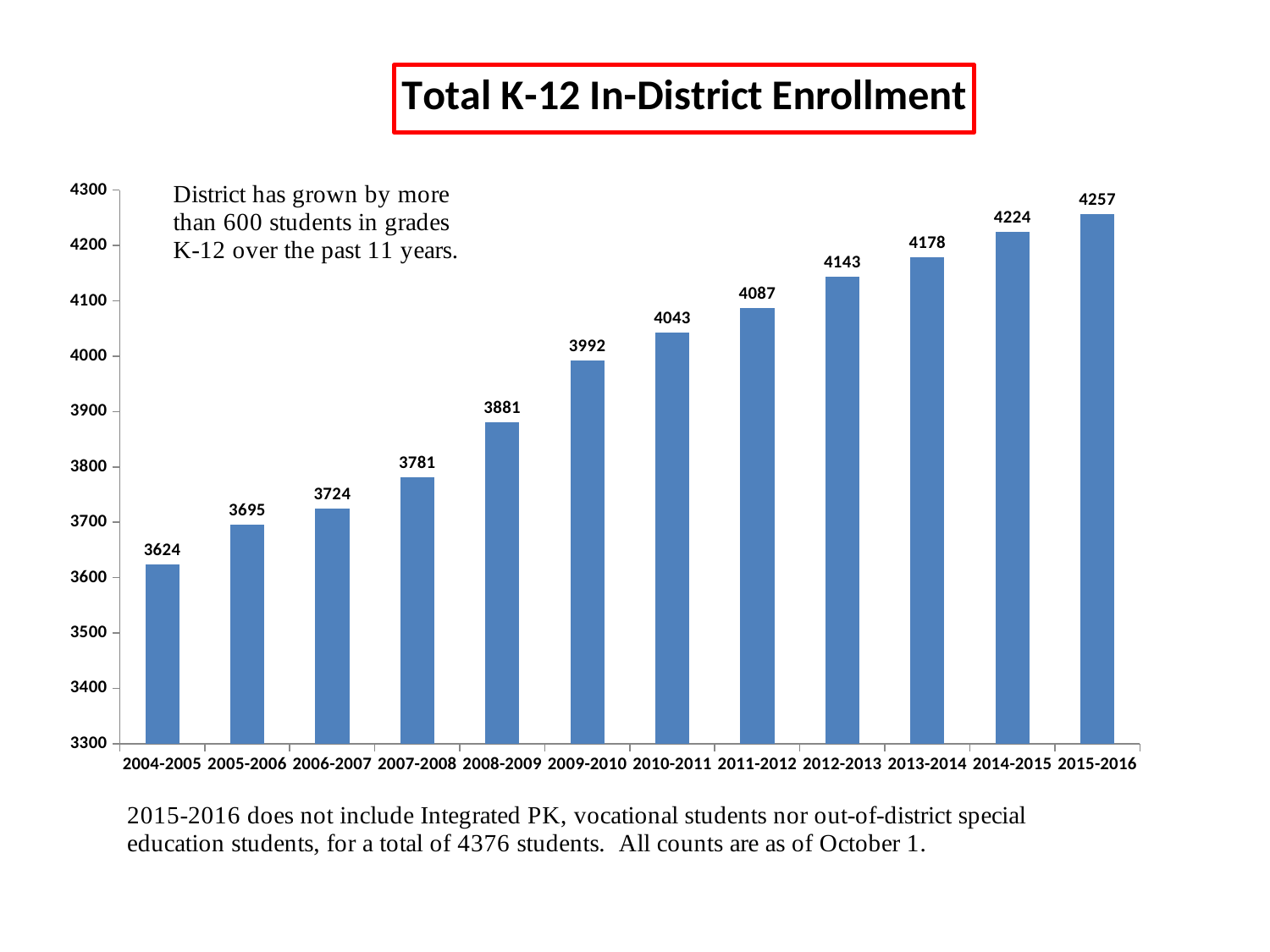
What is the enrollment value for 2004-2005? 3624 What is the enrollment value for 2015-2016? 4257 Which school year has the highest enrollment? 2015-2016 What is the enrollment value for 2010-2011? 4043 What is the difference in enrollment between 2009-2010 and 2008-2009? 111 What kind of chart is shown on the slide? bar chart What is the difference in enrollment between 2015-2016 and 2004-2005? 633 How many school years are shown on the x axis? 12 Do the enrollment values rise or fall from 2004-2005 to 2015-2016? rise Is the enrollment value for 2011-2012 greater or less than 4000? greater Which school year has the lowest enrollment? 2004-2005 Which is larger, the enrollment for 2007-2008 or for 2006-2007? 2007-2008